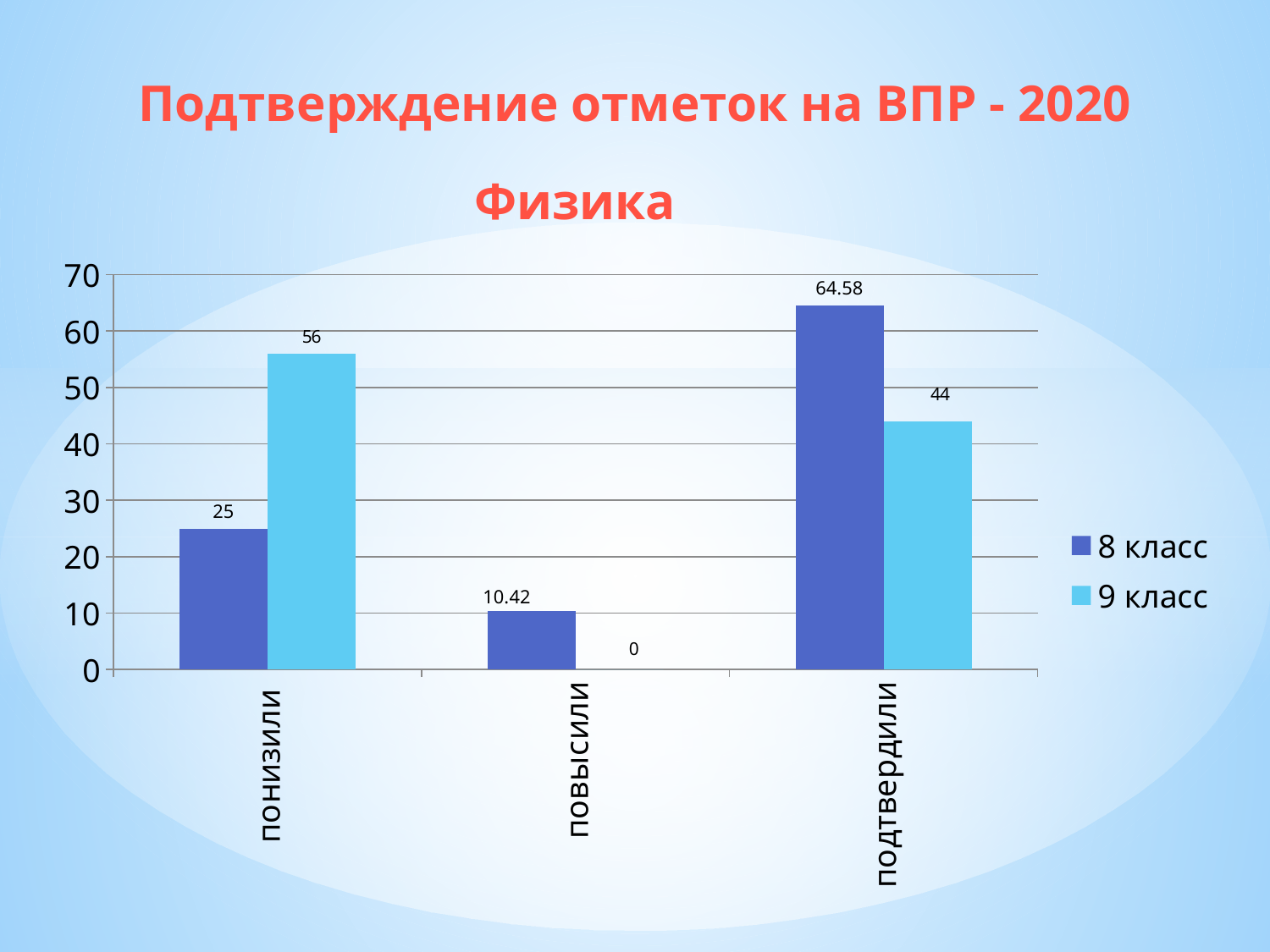
What is the value for 9 класс in the понизили category? 56 What is the difference between the 9 класс and 8 класс values in the понизили category? 31 What is the value for 8 класс in the понизили category? 25 What is the value for 8 класс in the повысили category? 10.42 What is the value for 9 класс in the повысили category? 0 What is the value for 8 класс in the подтвердили category? 64.58 What kind of chart is shown on the slide? bar chart What is the value for 9 класс in the подтвердили category? 44 Which category has the highest value for 8 класс? подтвердили Which category has the lowest value for 9 класс? повысили In the подтвердили category, which series has the larger value, 8 класс or 9 класс? 8 класс How many series does the legend list? 2